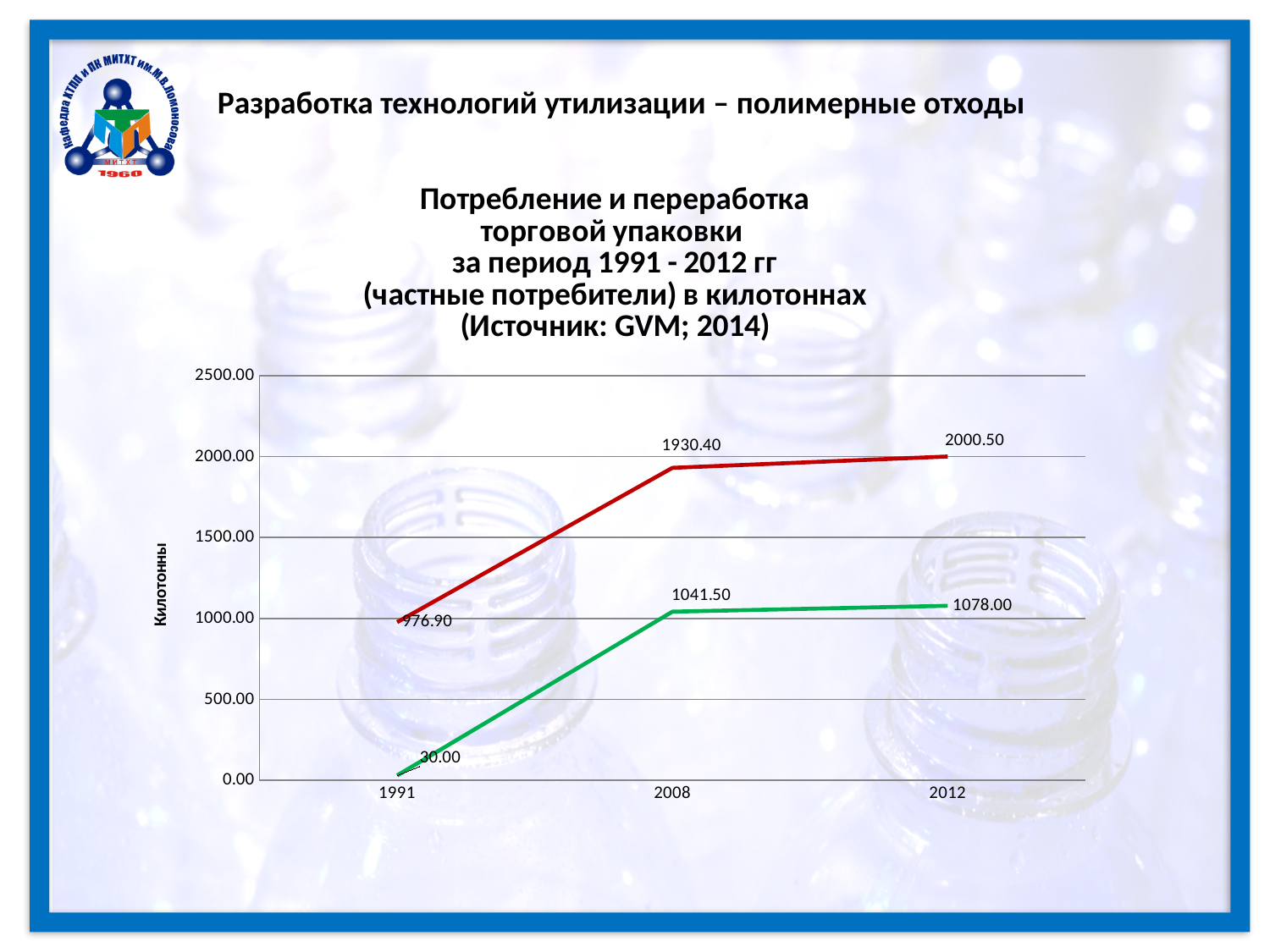
What is the value of the red line in 2012? 2000.50 What is the value of the red line in 2008? 1930.40 What is the difference between the red line and the green line values in 2012? 922.50 In which year does the green line have its lowest value? 1991 In which year does the red line reach its highest value? 2012 Do the values of the green line rise or fall from 1991 to 2012? rise What is the value of the red line in 1991? 976.90 What is the value of the green line in 2008? 1041.50 What is the value of the green line in 2012? 1078.00 What type of chart is shown on the slide? line chart How many years are shown on the x axis? 3 What is the value of the green line in 1991? 30.00